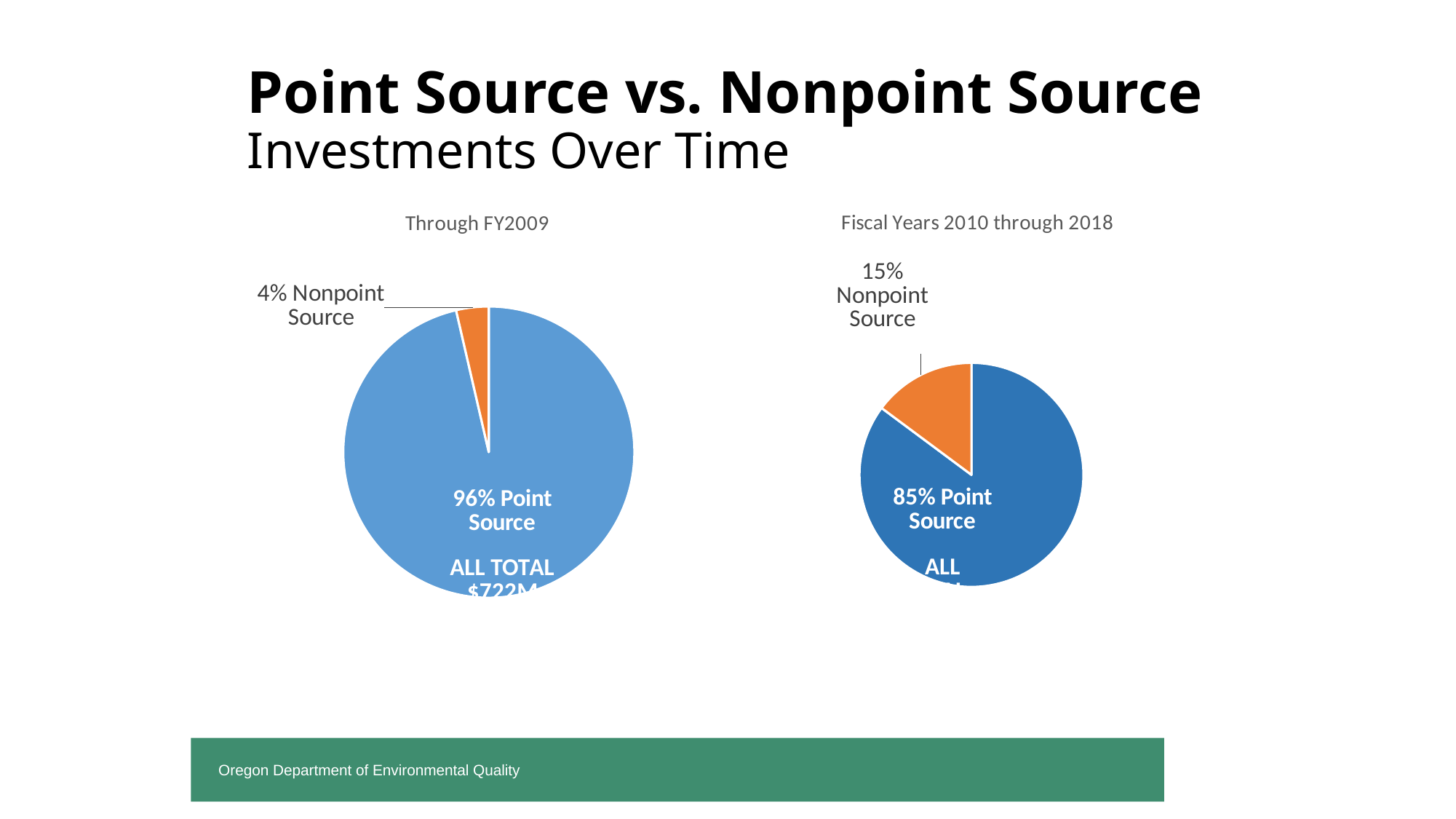
How many slices does the 'Fiscal Years 2010 through 2018' pie chart have? 2 In the 'Through FY2009' chart, which slice is the largest? Point Source In the 'Through FY2009' chart, what share of investments is Point Source? 96% In the 'Fiscal Years 2010 through 2018' chart, what is the difference in percentage points between the Point Source and Nonpoint Source shares? 70 Which chart shows a larger Nonpoint Source share, 'Through FY2009' or 'Fiscal Years 2010 through 2018'? Fiscal Years 2010 through 2018 In the 'Fiscal Years 2010 through 2018' chart, what share of investments is Nonpoint Source? 15% In the 'Fiscal Years 2010 through 2018' chart, what share of investments is Point Source? 85% In the 'Fiscal Years 2010 through 2018' chart, which slice is the smallest? Nonpoint Source What kind of chart is the 'Through FY2009' chart? Pie chart How many pie charts are shown on the slide? 2 In the 'Through FY2009' chart, what colour is the Nonpoint Source slice? Orange